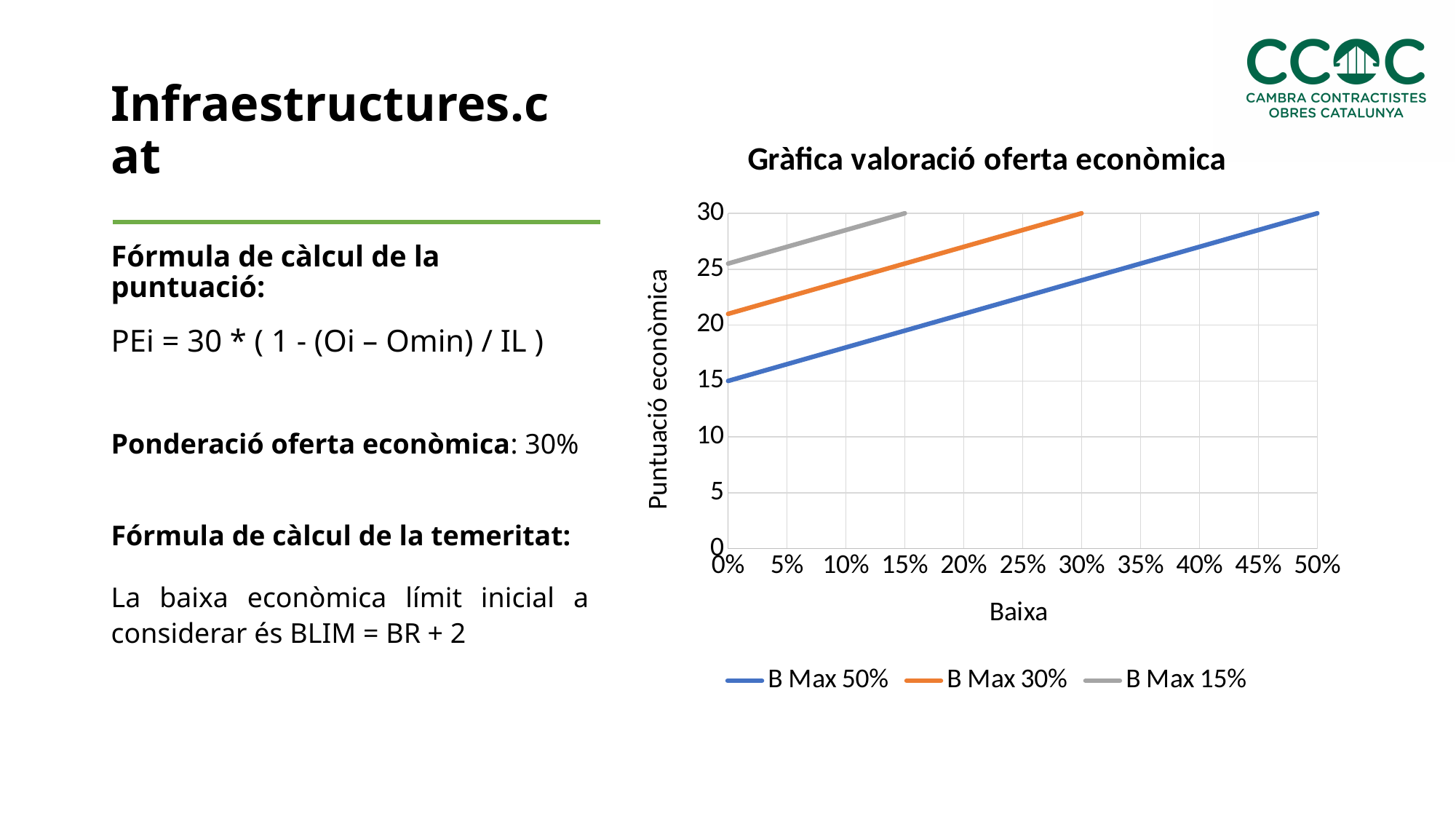
What is the value of the B Max 50% series at a Baixa of 0%? 15 Is the value of the B Max 15% series at a Baixa of 0% greater or less than 20? greater What is the label of the vertical axis of the chart? Puntuació econòmica At a Baixa of 10%, which series has the higher value, B Max 15% or B Max 50%? B Max 15% Is the value of the B Max 30% series at a Baixa of 0% greater or less than 25? less Do the values of the B Max 50% series rise or fall as Baixa increases? rise At what Baixa does the B Max 30% series reach 30 points? 30% What kind of chart is shown on the slide? line chart At what Baixa does the B Max 15% series reach 30 points? 15% What is the title of the chart? Gràfica valoració oferta econòmica How many series does the legend of the chart list? 3 What is the value of the B Max 50% series at a Baixa of 50%? 30